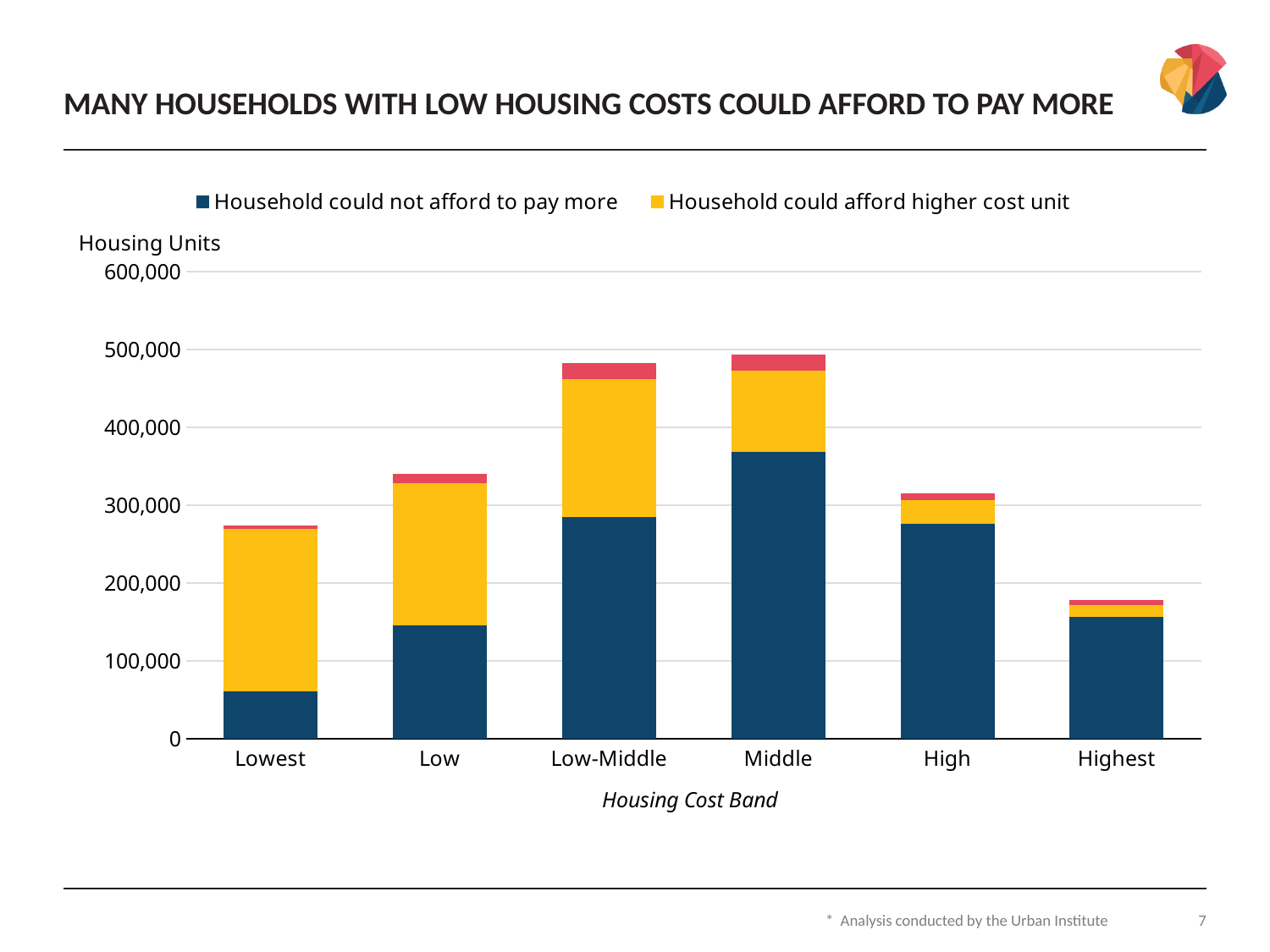
What is the label on the x axis of the chart? Housing Cost Band What kind of chart is shown on the slide? Stacked bar chart Which cost band has more housing units where the household could afford a higher cost unit: Lowest or Highest? Lowest Is the total number of housing units for the Middle cost band greater or less than 400,000? greater Is the number of housing units where the household could not afford to pay more in the Lowest cost band greater or less than 100,000? less Is the total number of housing units for the Lowest cost band greater or less than 300,000? less Which housing cost band has the lowest total number of housing units? Highest Which cost band has more housing units where the household could not afford to pay more: Middle or Lowest? Middle How many series does the legend list? 2 What is the label on the y axis of the chart? Housing Units How many housing cost bands are shown on the x axis? 6